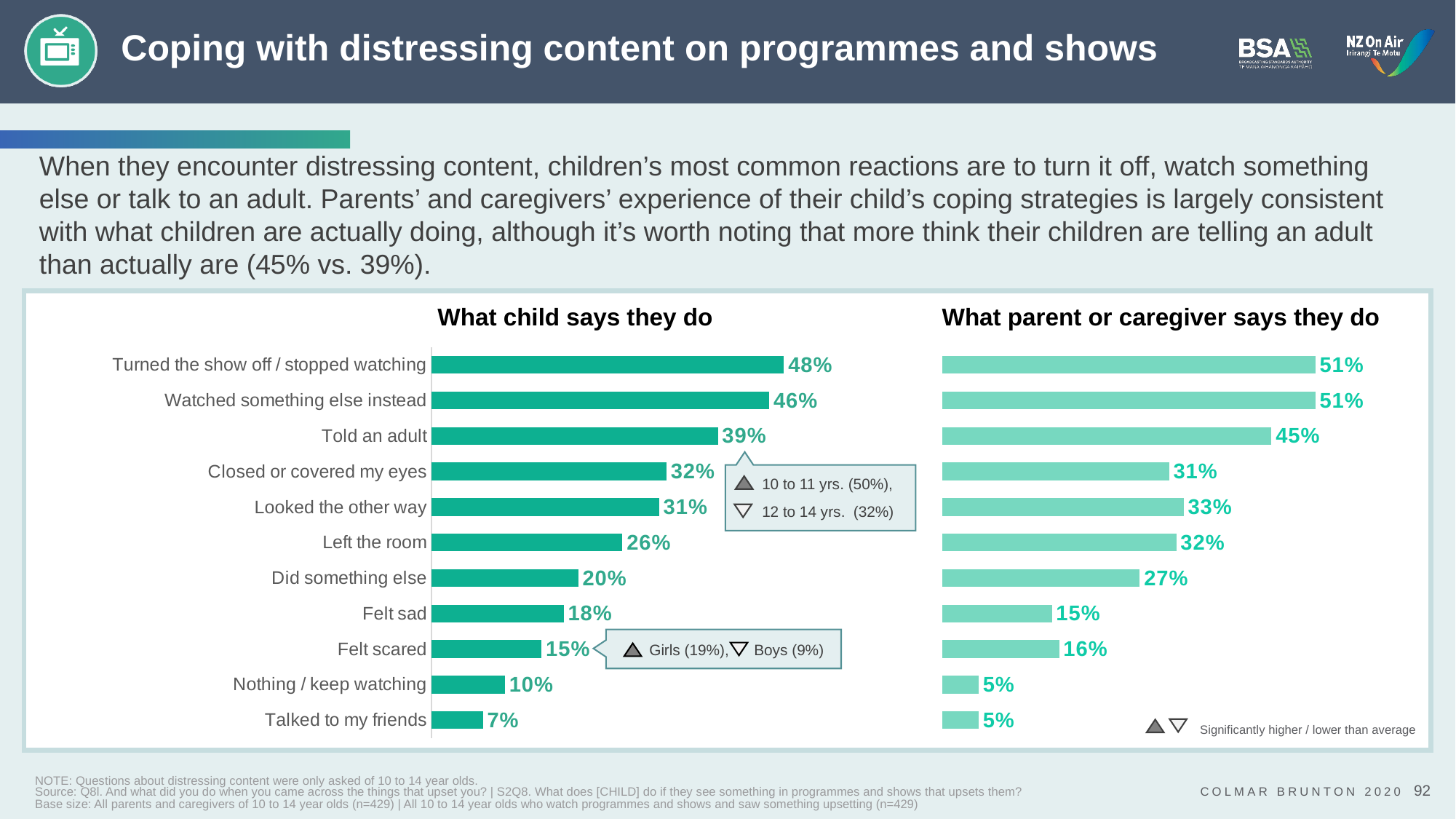
How many categories are shown in the 'What child says they do' chart? 11 In the 'What child says they do' chart, which is larger: 'Felt sad' or 'Felt scared'? Felt sad What is the difference between the 'Told an adult' values in the parent/caregiver chart and the child chart? 6 percentage points In the 'What parent or caregiver says they do' chart, what is the value for 'Did something else'? 27% What type of chart is used on this slide? Bar chart In the 'What child says they do' chart, which category has the lowest value? Talked to my friends In the 'What parent or caregiver says they do' chart, what is the value for 'Left the room'? 32% In the 'What child says they do' chart, what is the value for 'Told an adult'? 39% In the 'What child says they do' chart, which category has the highest value? Turned the show off / stopped watching In the 'What child says they do' chart, what is the difference between 'Turned the show off / stopped watching' and 'Watched something else instead'? 2 percentage points What is the title of the right-hand chart? What parent or caregiver says they do In the 'What parent or caregiver says they do' chart, what is the value for 'Nothing / keep watching'? 5%